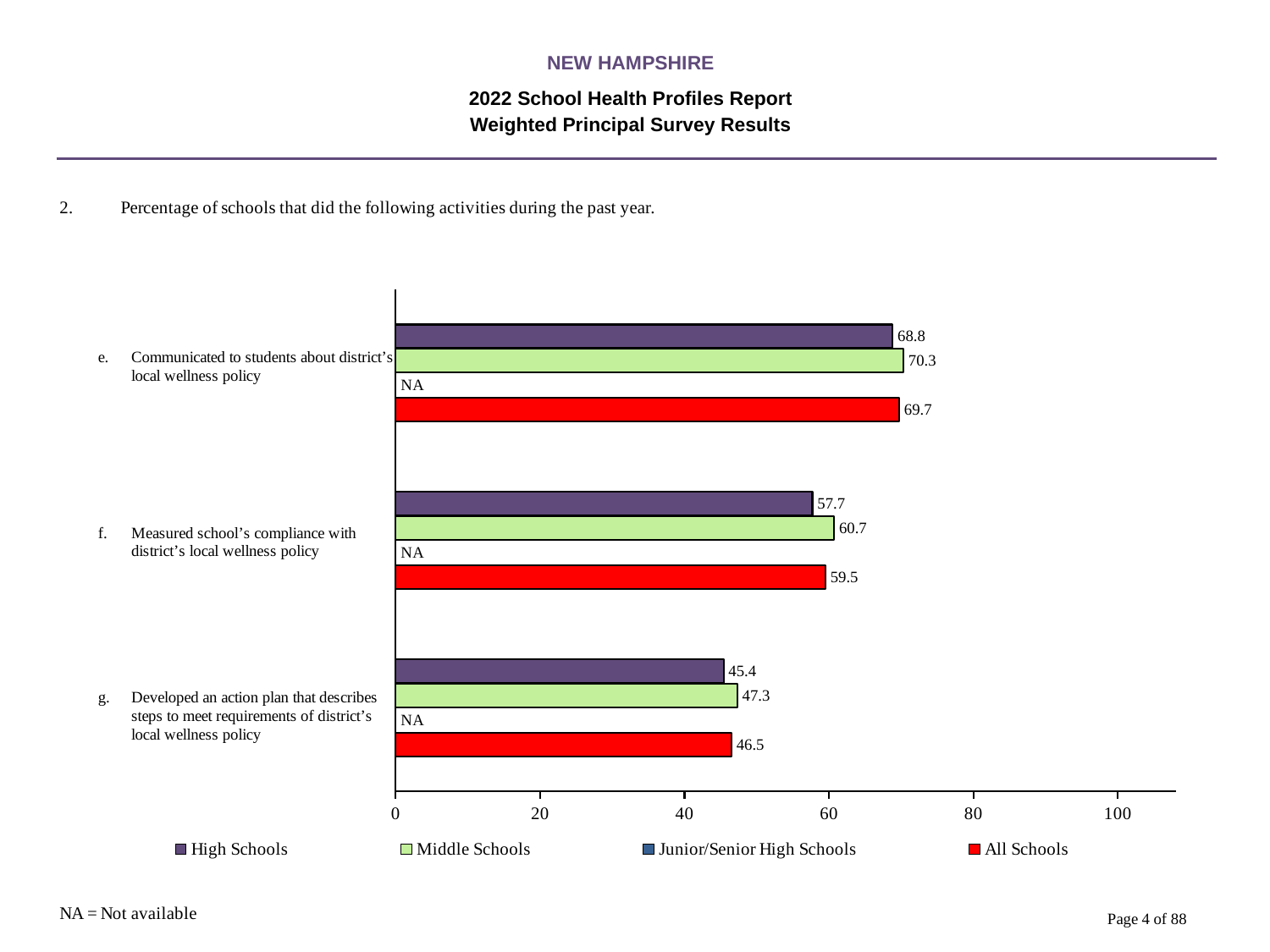
Which activity has the lowest value for All Schools? Developed an action plan that describes steps to meet requirements of district's local wellness policy What is the value for Middle Schools for 'Measured school's compliance with district's local wellness policy'? 60.7 What is the difference between the Middle Schools and High Schools values for 'Measured school's compliance with district's local wellness policy'? 3.0 What does NA stand for according to the note on the slide? Not available What value is shown for Junior/Senior High Schools for 'Measured school's compliance with district's local wellness policy'? NA How many activities (categories) are shown on the chart? 3 How many series does the legend list? 4 Which activity has the highest value for Middle Schools? Communicated to students about district's local wellness policy What is the value for High Schools for 'Communicated to students about district's local wellness policy'? 68.8 For 'Developed an action plan that describes steps to meet requirements of district's local wellness policy', which is larger: the High Schools value or the Middle Schools value? Middle Schools What kind of chart is shown on the slide? Bar chart What is the value for All Schools for 'Developed an action plan that describes steps to meet requirements of district's local wellness policy'? 46.5